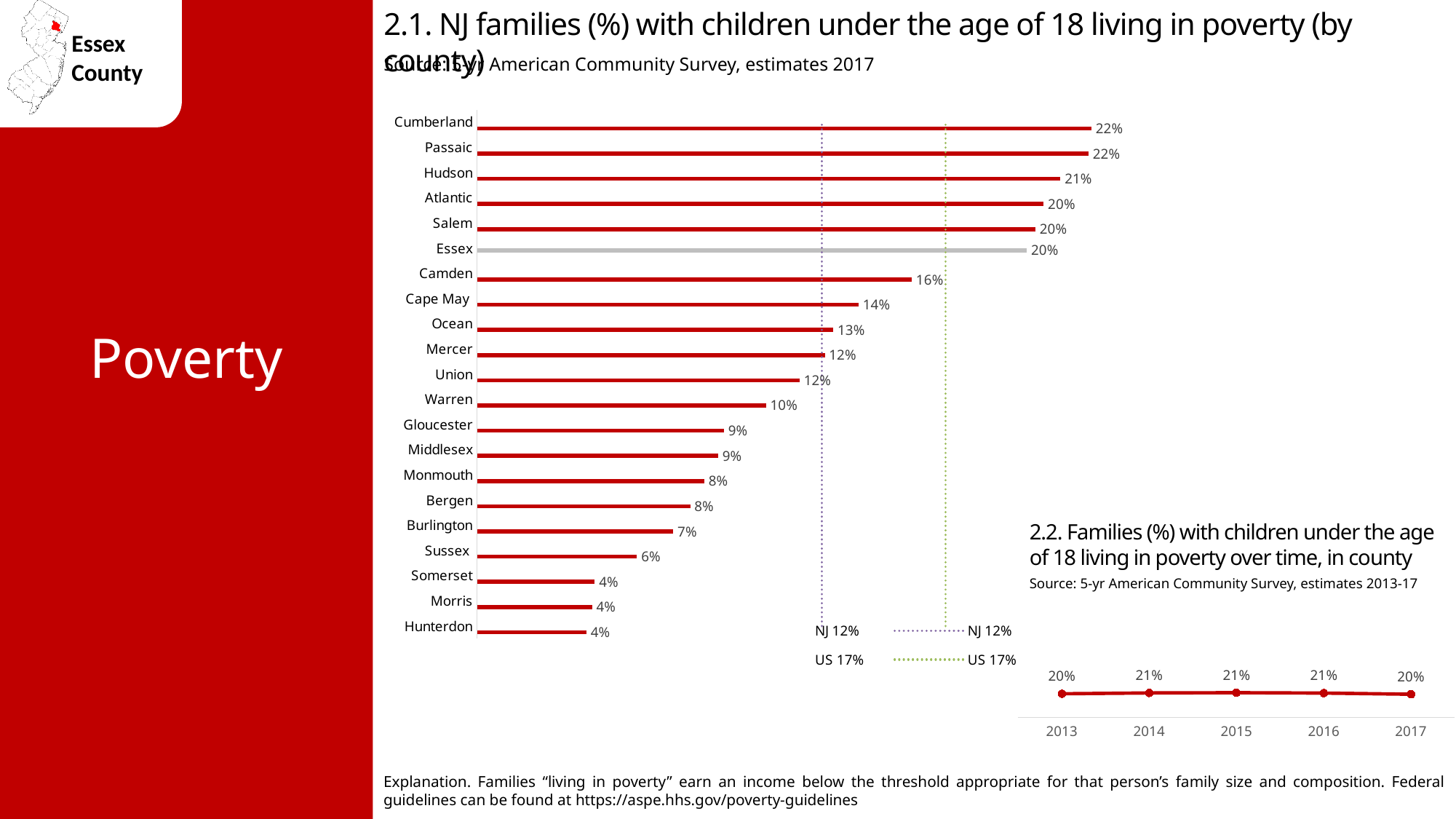
In chart 2.1, what kind of chart is used? Bar chart In chart 2.2, how many years are plotted? 5 In chart 2.2, what is the value for 2015? 21% In chart 2.1, what is the US reference value shown by the dotted line? 17% In chart 2.1, what percentage of families with children under 18 live in poverty in Essex County? 20% In chart 2.1, what is the difference between the values for Cumberland and Essex? 2% In chart 2.2, what kind of chart is used? Line chart In chart 2.1, what is the value shown for Camden? 16% In chart 2.1, what is the value shown for Hunterdon? 4% In chart 2.1, which has a higher value, Hudson or Ocean? Hudson In chart 2.1, how many counties are listed? 21 In chart 2.2, what is the difference between the values for 2014 and 2017? 1%